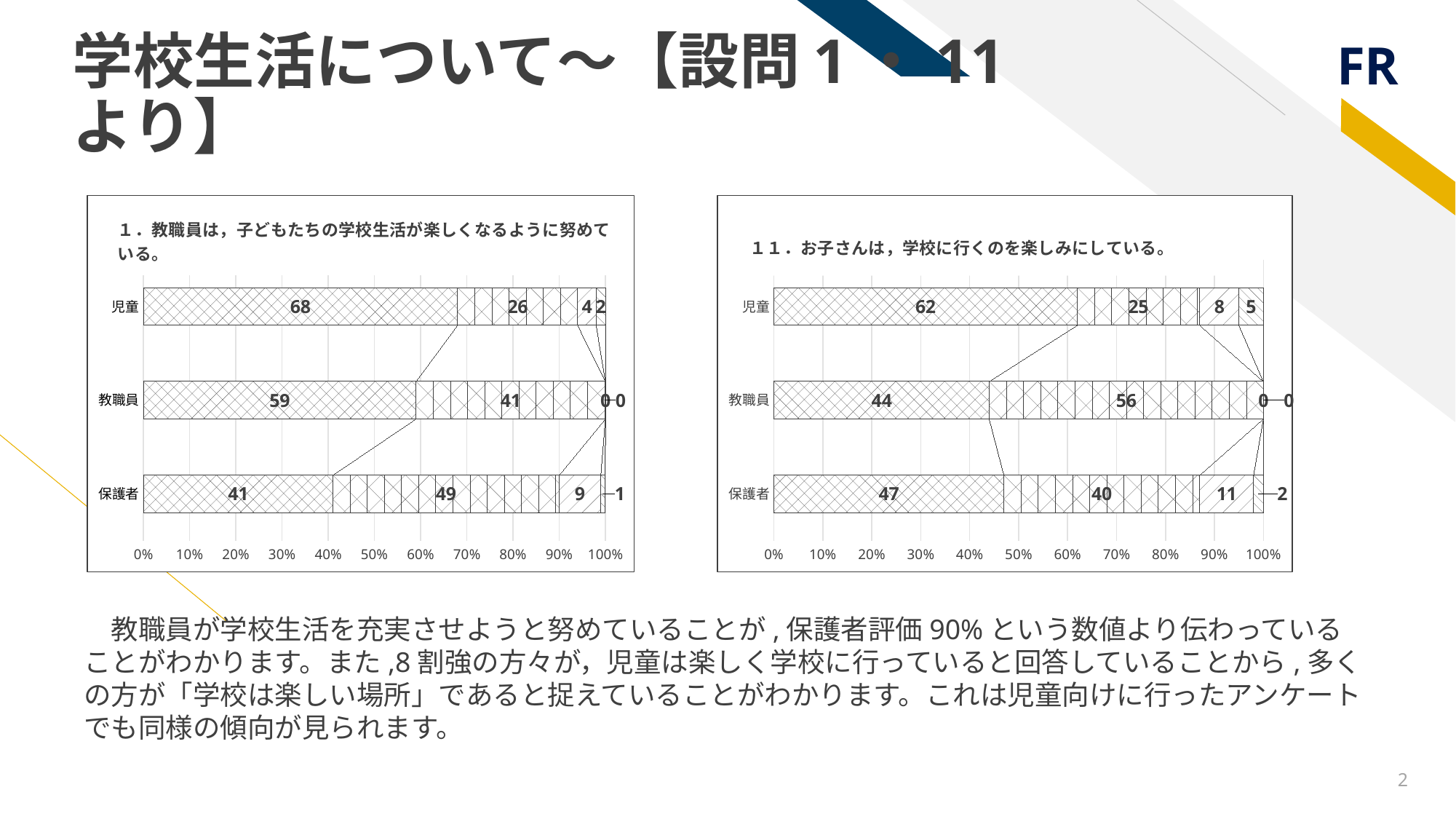
What kind of chart is the left chart (設問1)? stacked bar chart In the left chart (設問1), what is the difference between the first-segment values for 児童 and 保護者? 27 In the right chart (設問11), what is the total of the segments for 児童? 100 In the left chart (設問1), which category has the highest value in the first (leftmost) segment? 児童 In the right chart (設問11), what is the value of the first (leftmost) segment for 教職員? 44 In the left chart (設問1), what is the value of the first (leftmost) segment for 児童? 68 In the right chart (設問11), what is the value of the third segment for 保護者? 11 In the right chart (設問11), which category has the lowest value in the first (leftmost) segment? 教職員 In the right chart (設問11), is the second-segment value for 教職員 larger or smaller than the second-segment value for 児童? larger In the left chart (設問1), what is the value of the second segment for 教職員? 41 How many categories are shown on the y axis of the right chart (設問11)? 3 In the left chart (設問1), what is the value of the third segment for 保護者? 9